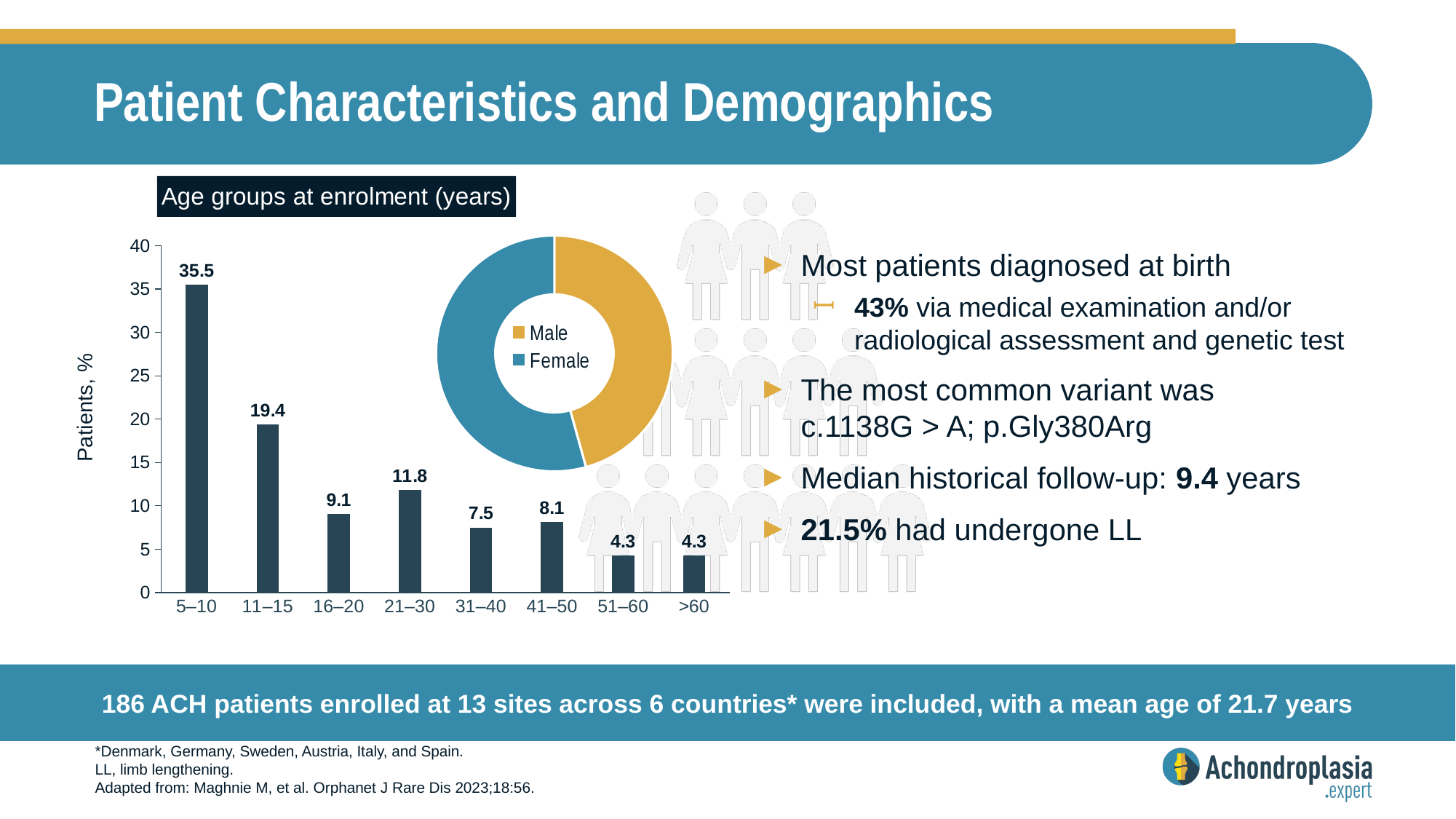
In the 'Age groups at enrolment (years)' chart, which age group has the highest value? 5–10 How many categories does the legend of the donut chart in the middle of the slide list? 2 What is the y-axis label of the 'Age groups at enrolment (years)' chart? Patients, % What kind of chart is the 'Age groups at enrolment (years)' chart? bar chart How many age groups are shown in the 'Age groups at enrolment (years)' chart? 8 In the 'Age groups at enrolment (years)' chart, which is larger, the value for 16–20 or for 21–30? 21–30 In the 'Age groups at enrolment (years)' chart, what is the value for the 21–30 age group? 11.8 In the 'Age groups at enrolment (years)' chart, what is the difference between the values for the 5–10 and 11–15 age groups? 16.1 In the 'Age groups at enrolment (years)' chart, what is the value for the 5–10 age group? 35.5 In the 'Age groups at enrolment (years)' chart, which age groups have the lowest value? 51–60 and >60 In the 'Age groups at enrolment (years)' chart, do the values generally rise or fall from the youngest to the oldest age group? fall In the donut chart in the middle of the slide, which slice is larger, Male or Female? Female